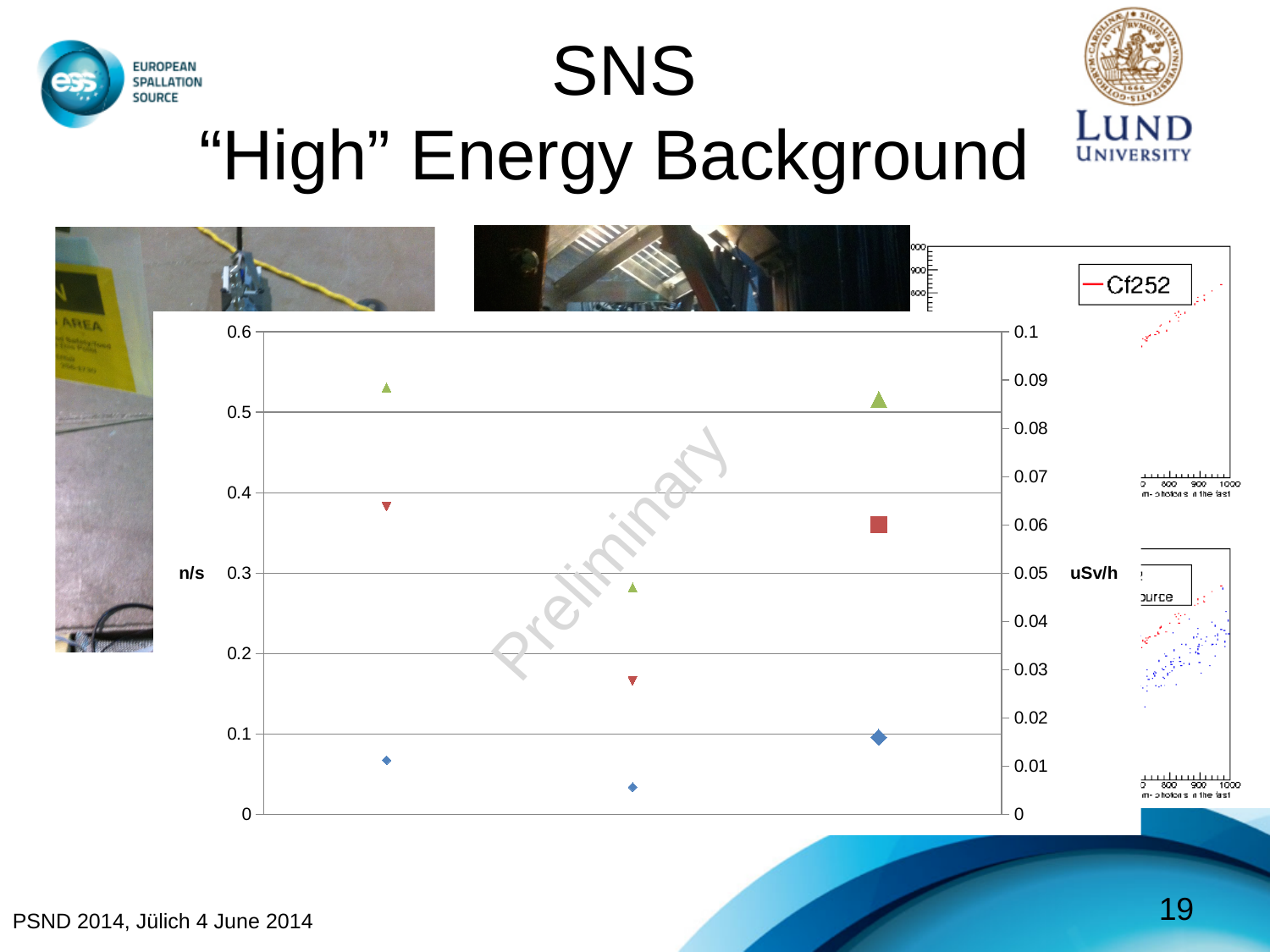
What is the label on the right vertical axis of the chart? uSv/h Is the red square marker greater or less than 0.4 on the left (n/s) axis? less What kind of chart is shown on the slide? scatter chart Is the middle green triangle marker greater or less than 0.3 on the left (n/s) axis? less Is the leftmost green triangle marker greater or less than 0.5 on the left (n/s) axis? greater What is the label on the left vertical axis of the chart? n/s What is the maximum value shown on the right vertical axis (uSv/h)? 0.1 What is the maximum value shown on the left vertical axis (n/s)? 0.6 How many blue diamond markers are plotted on the chart? 3 How many green triangle markers are plotted on the chart? 3 Which marker colour has the lowest plotted values on the chart? blue